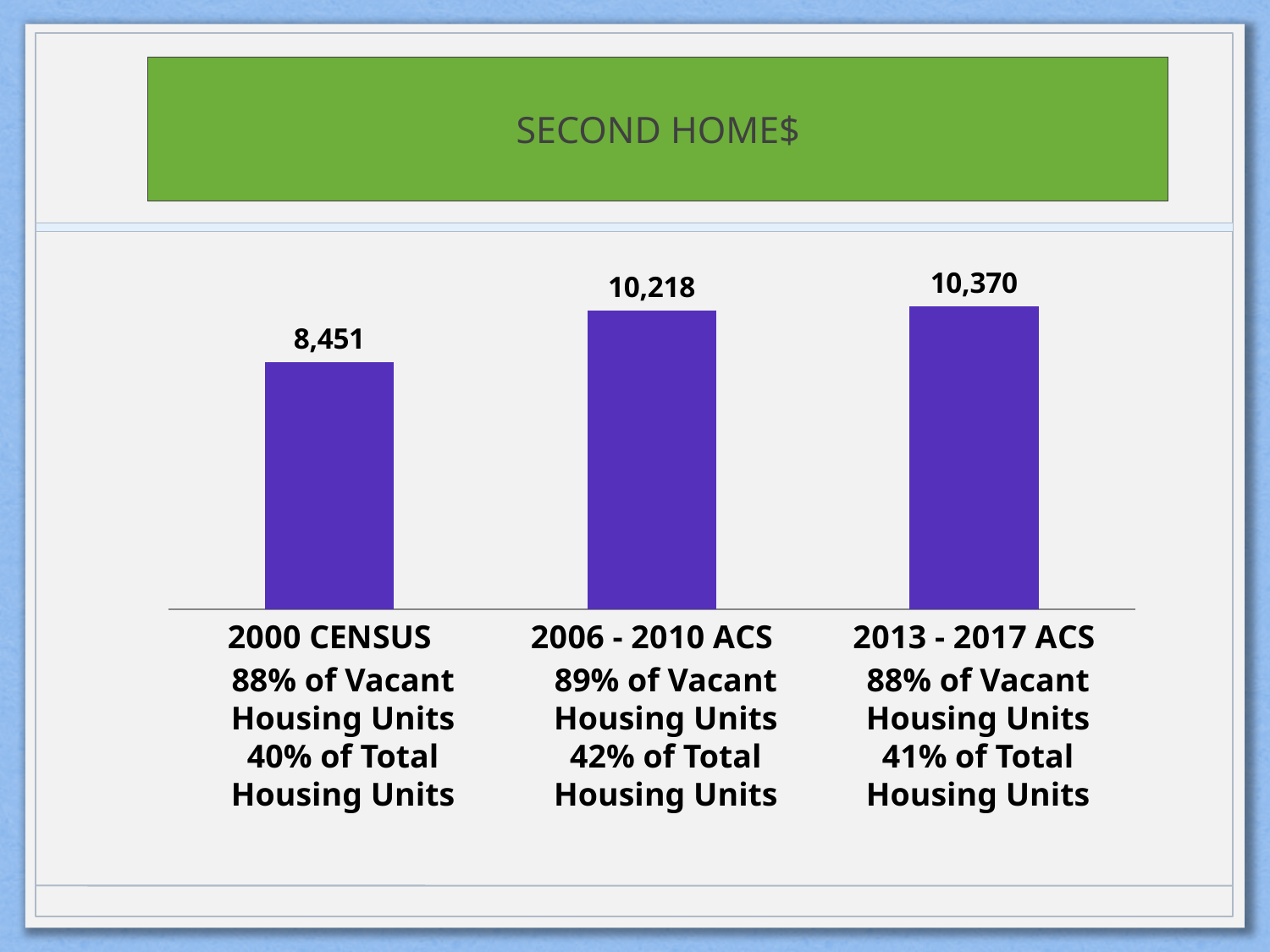
What is the value for 2000 CENSUS? 8,451 Which is larger, the value for 2000 CENSUS or the value for 2006 - 2010 ACS? 2006 - 2010 ACS Which category has the lowest value? 2000 CENSUS What kind of chart is shown on the slide? bar chart What is the value for 2006 - 2010 ACS? 10,218 Which category has the highest value? 2013 - 2017 ACS How many categories are shown on the chart? 3 What is the title shown above the chart? SECOND HOME$ What is the value for 2013 - 2017 ACS? 10,370 What is the difference between the values for 2013 - 2017 ACS and 2000 CENSUS? 1,919 Do the values rise or fall from 2000 CENSUS to 2013 - 2017 ACS? rise What is the difference between the values for 2006 - 2010 ACS and 2000 CENSUS? 1,767